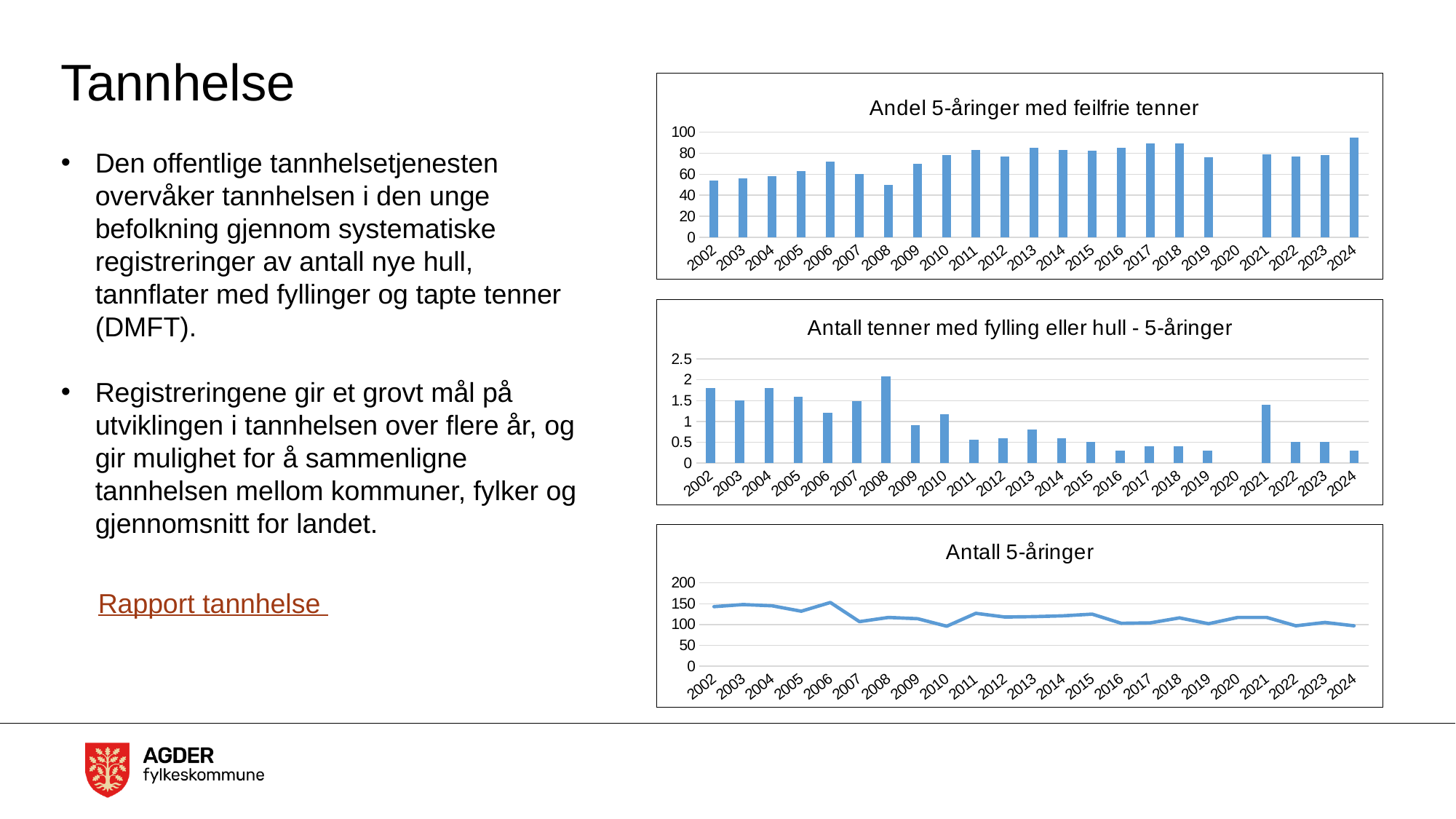
How many years are labelled on the x axis of the top chart 'Andel 5-åringer med feilfrie tenner'? 23 In the top chart 'Andel 5-åringer med feilfrie tenner', which year has the highest value? 2024 In the middle chart 'Antall tenner med fylling eller hull - 5-åringer', which year has the highest value? 2008 In the middle chart 'Antall tenner med fylling eller hull - 5-åringer', is the value for 2011 greater or less than 1? less In the bottom chart 'Antall 5-åringer', is the value for 2007 greater or less than 150? less In the top chart 'Andel 5-åringer med feilfrie tenner', which year has the lowest value? 2008 What kind of chart is the top chart, 'Andel 5-åringer med feilfrie tenner'? bar chart In the middle chart 'Antall tenner med fylling eller hull - 5-åringer', is the value for 2021 greater or less than 1? greater In the top chart 'Andel 5-åringer med feilfrie tenner', which is larger, the value for 2002 or the value for 2024? 2024 What kind of chart is the bottom chart, 'Antall 5-åringer'? line chart In the bottom chart 'Antall 5-åringer', which year has the highest value? 2006